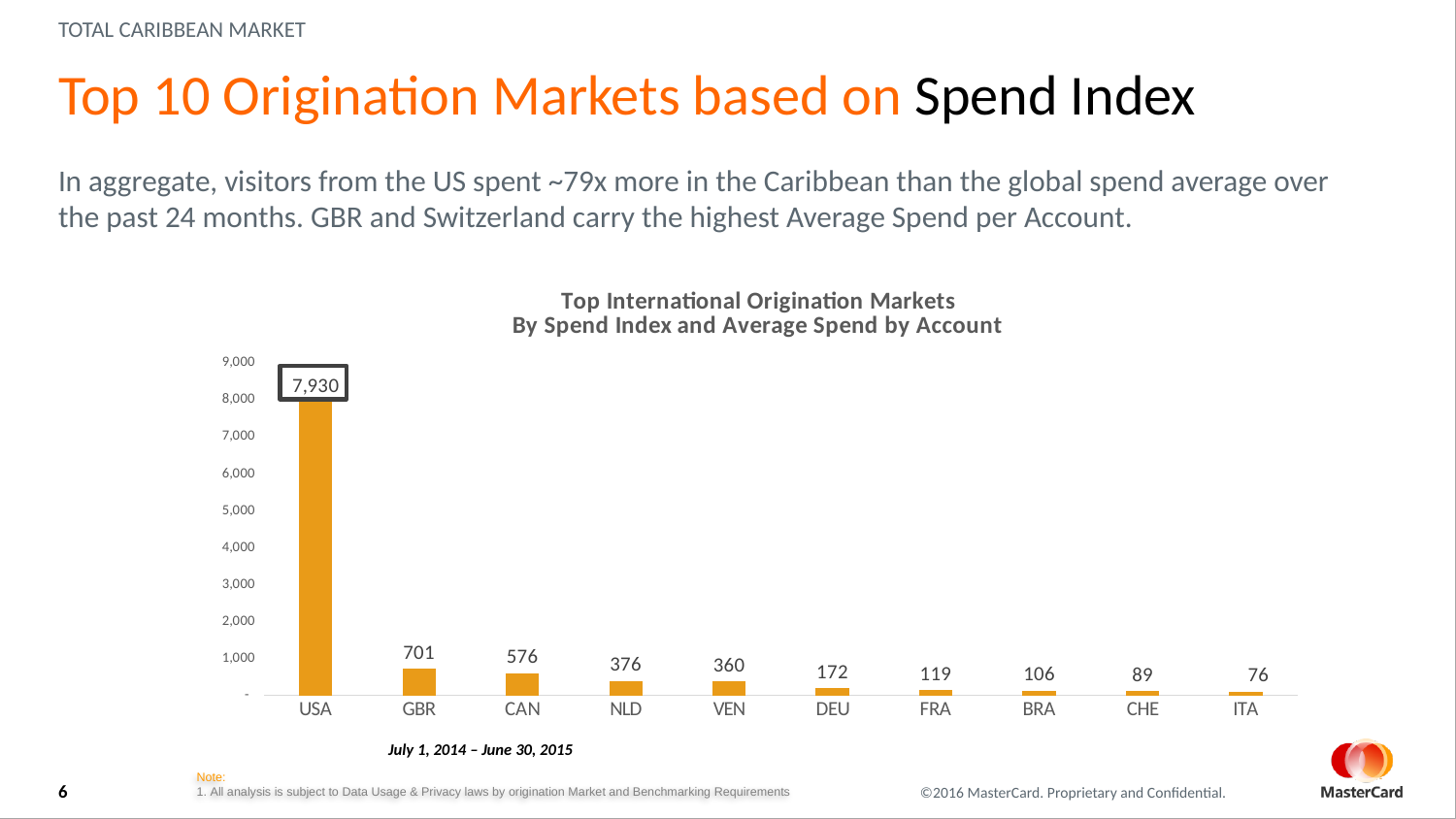
Is the value for USA greater or less than 7,000? greater What date range is shown below the chart? July 1, 2014 – June 30, 2015 Which origination market has the highest spend index? USA What is the spend index value for ITA? 76 What is the spend index value for VEN? 360 Which has a higher spend index, NLD or DEU? NLD Which origination market has the lowest spend index? ITA What is the spend index value for GBR? 701 What kind of chart is shown on the slide? Bar chart What is the spend index value for USA? 7,930 How many origination markets are shown in the chart? 10 What is the difference between the spend index values for GBR and CAN? 125